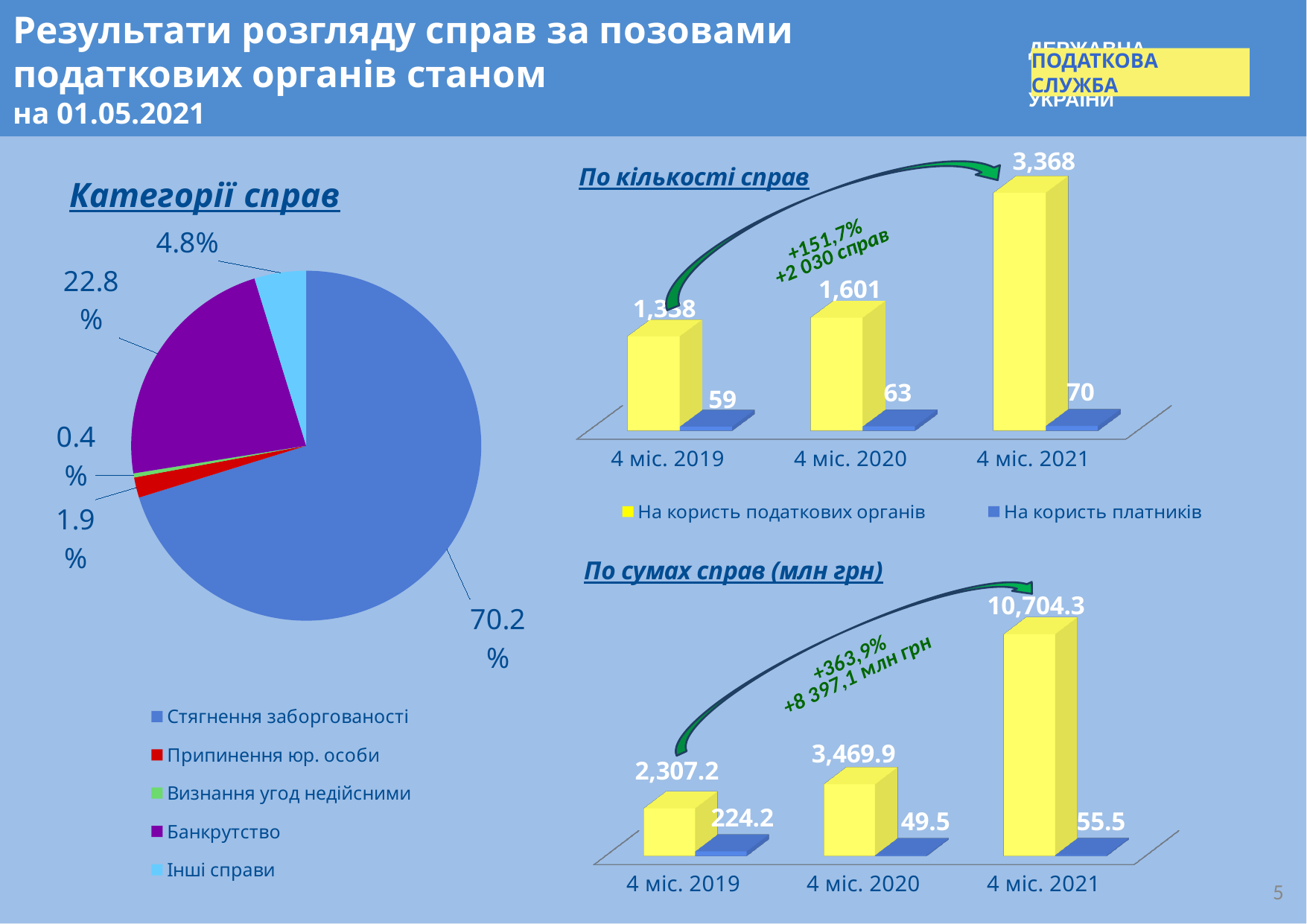
In the chart 'По сумах справ (млн грн)', which period has the highest value of the blue bars? 4 міс. 2019 In the pie chart 'Категорії справ', which category has the largest share? Стягнення заборгованості In the pie chart 'Категорії справ', what share does 'Банкрутство' have? 22.8% What kind of chart is 'По сумах справ (млн грн)'? bar chart In the chart 'По сумах справ (млн грн)', what is the value of the yellow bar for 4 міс. 2020? 3,469.9 In the chart 'По кількості справ', what is the value for 'На користь податкових органів' in 4 міс. 2021? 3,368 In the chart 'По кількості справ', what is the difference between the 'На користь податкових органів' values for 4 міс. 2021 and 4 міс. 2020? 1,767 In the chart 'По кількості справ', what is the value for 'На користь платників' in 4 міс. 2019? 59 In the chart 'По кількості справ', do the 'На користь податкових органів' values rise or fall from 4 міс. 2019 to 4 міс. 2021? rise In the pie chart 'Категорії справ', which category has the smallest share? Визнання угод недійсними How many categories does the legend of the pie chart 'Категорії справ' list? 5 How many series does the legend of the chart 'По кількості справ' list? 2